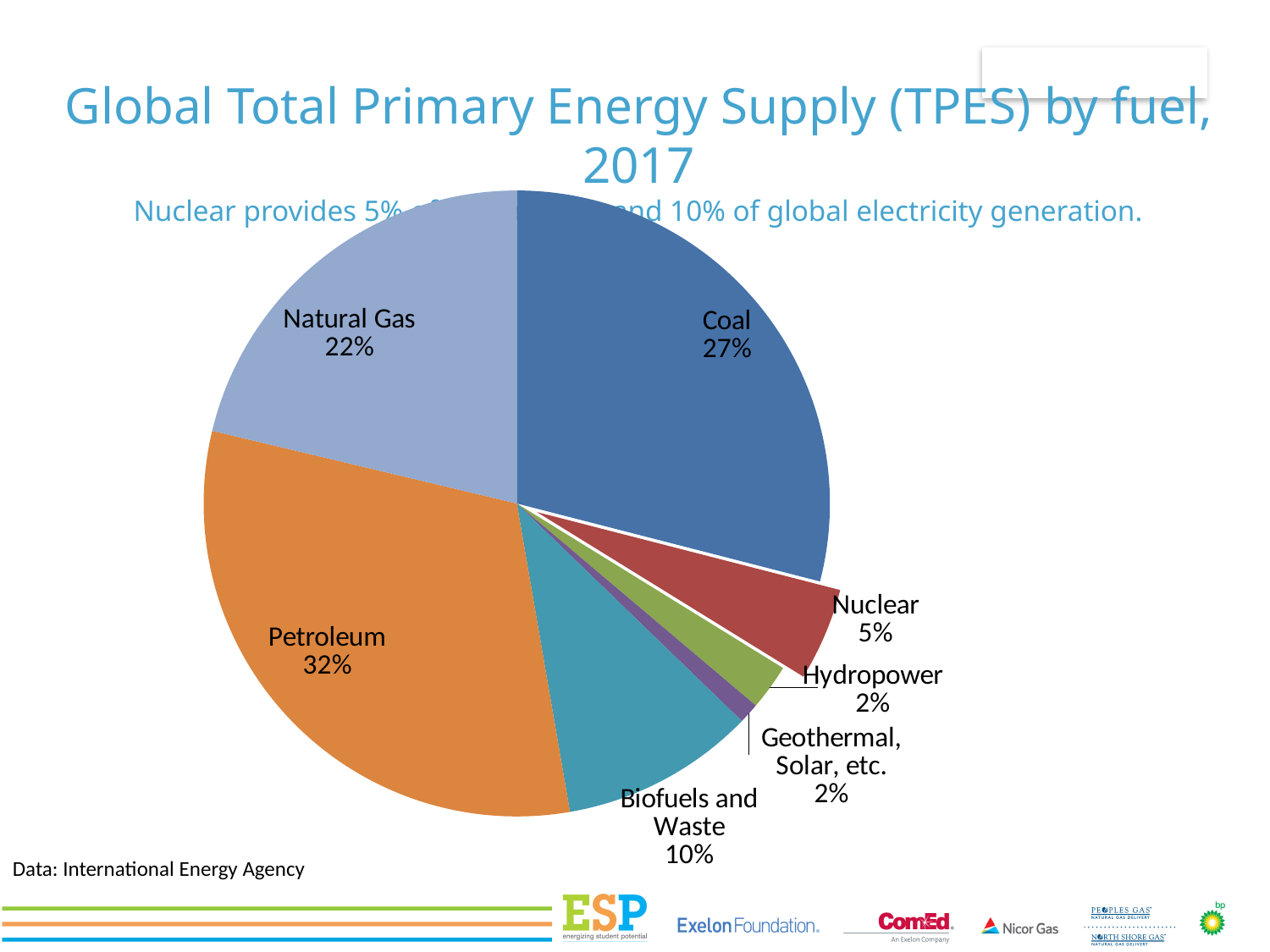
What percentage is shown for Biofuels and Waste? 10% What is the combined share of Coal and Petroleum? 59% How many slices does the pie chart have? 7 Which fuel has the largest slice of the pie? Petroleum What percentage is shown for Natural Gas? 22% What percentage is shown for Hydropower? 2% What share does Nuclear have in the pie chart? 5% What kind of chart is shown on the slide? pie chart What share of global total primary energy supply does Coal provide? 27% Which is larger, the share for Coal or the share for Natural Gas? Coal What is the difference in percentage points between Petroleum and Coal? 5 What is the title of the chart? Global Total Primary Energy Supply (TPES) by fuel, 2017